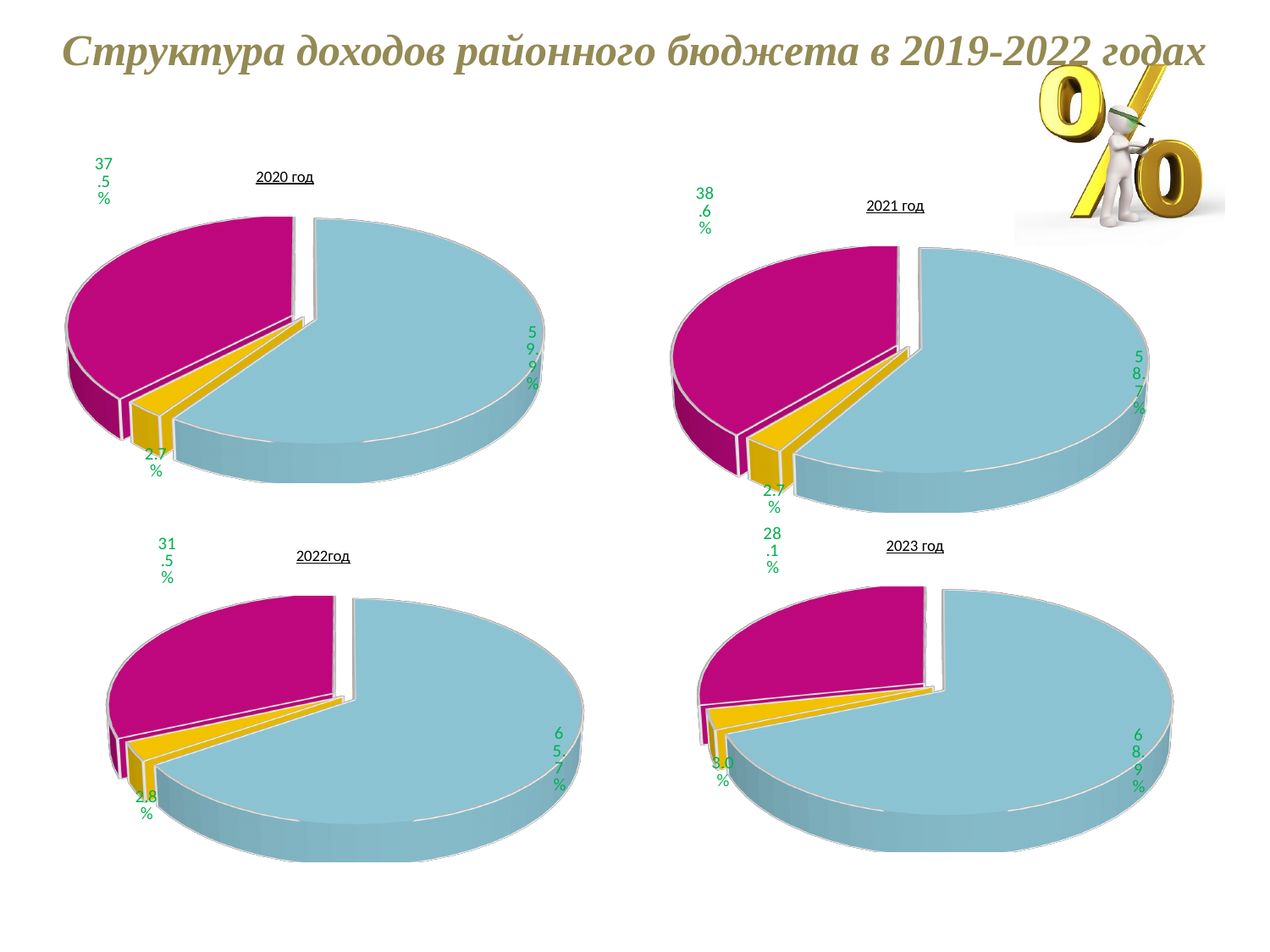
Which is larger: the magenta slice in the 2021 год chart or the magenta slice in the 2023 год chart? 2021 год In the 2020 год chart, what share does the light blue slice represent? 59.9% In the 2021 год chart, what share does the yellow slice represent? 2.7% In the 2020 год chart, what share does the magenta slice represent? 37.5% In the 2023 год chart, what share does the yellow slice represent? 3.0% In the 2020 год chart, what is the difference between the light blue slice and the magenta slice? 22.4% What type of chart is used for the 2022год data? pie chart In the 2021 год chart, what share does the magenta slice represent? 38.6% In the 2022год chart, what share does the light blue slice represent? 65.7% How many slices does the 2021 год pie chart have? 3 In the 2023 год chart, which colour slice is the largest? light blue In the 2022год chart, which colour slice is the smallest? yellow